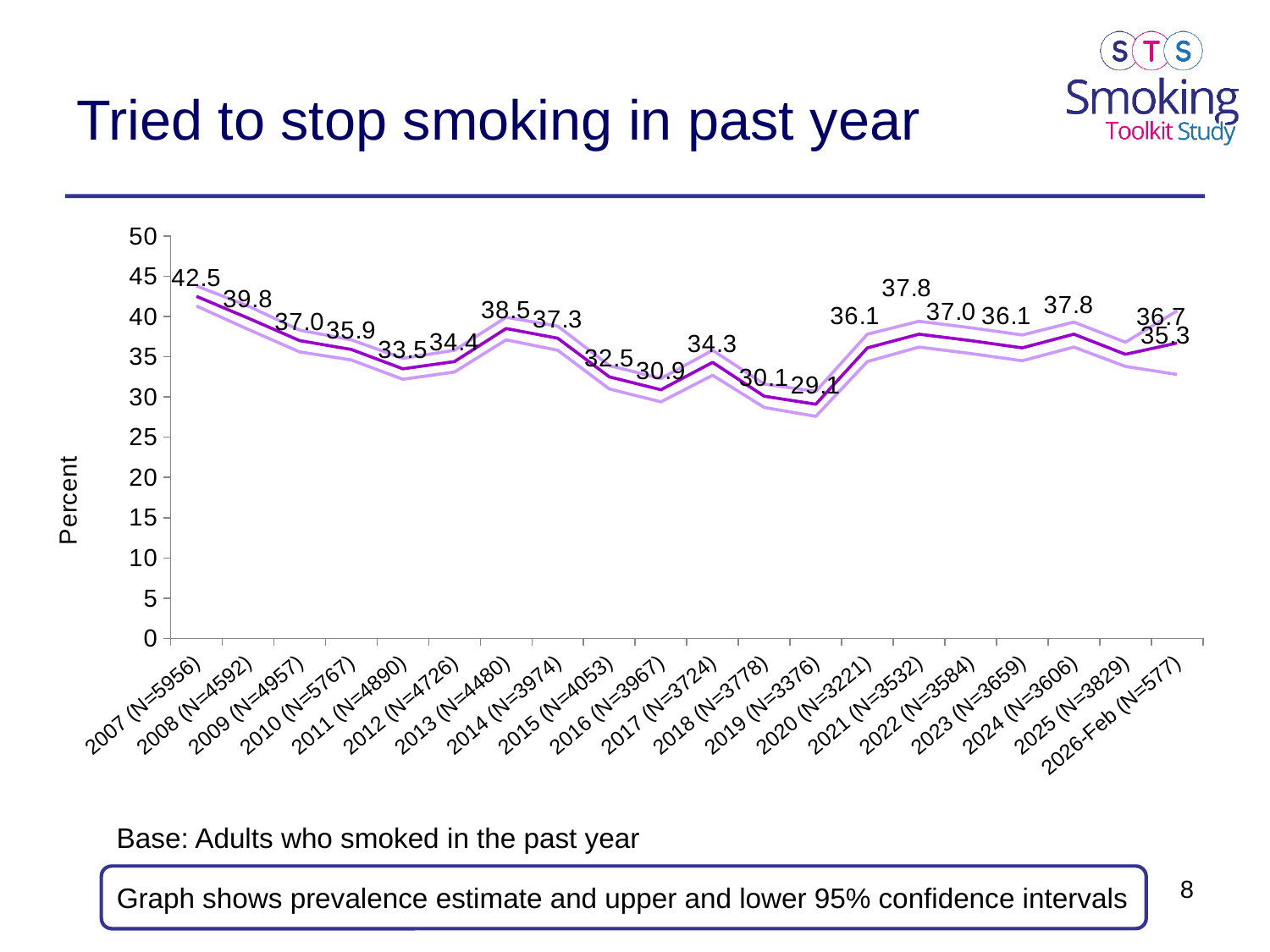
What is the prevalence estimate for 2007 (N=5956)? 42.5 Which has the higher prevalence estimate, 2013 or 2014? 2013 How many time points are plotted on the x axis? 20 What is the prevalence estimate for 2021 (N=3532)? 37.8 Which year has the highest prevalence estimate? 2007 (N=5956) What is the prevalence estimate for 2013 (N=4480)? 38.5 What is the label on the y axis? Percent Does the prevalence estimate rise or fall from 2007 to 2011? fall What is the difference between the prevalence estimates for 2007 and 2019? 13.4 What is the prevalence estimate for 2019 (N=3376)? 29.1 Which year has the lowest prevalence estimate? 2019 (N=3376) What kind of chart is shown on the slide? line chart